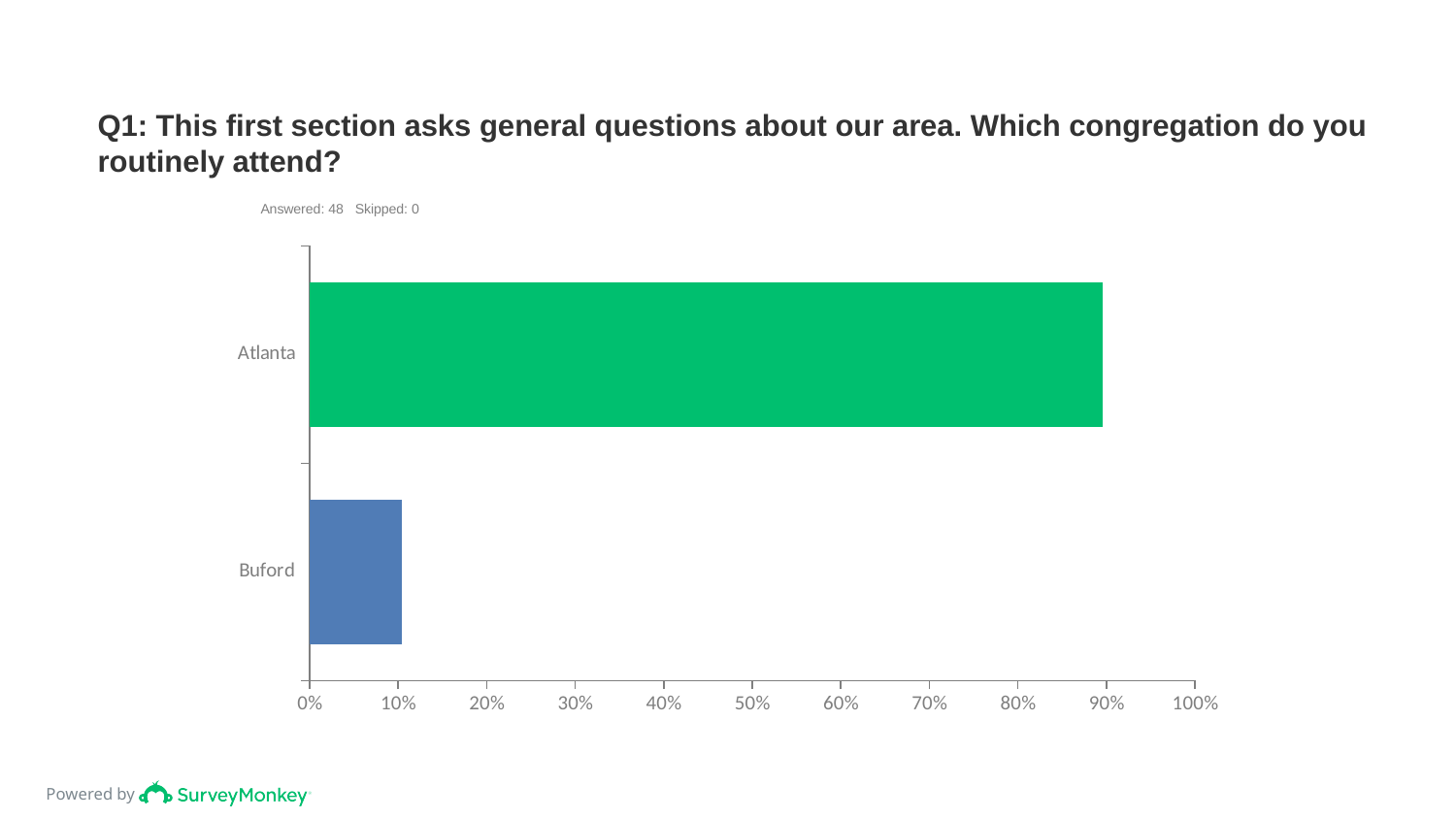
Is the value for Atlanta greater or less than 80%? greater Which congregation has the lowest value in the chart? Buford How many categories (congregations) are plotted in the chart? 2 Is the value for Buford greater or less than 20%? less What kind of chart is shown on the slide? bar chart How many respondents answered the question shown in the chart? 48 Is the value for Buford greater or less than 50%? less Which is larger, the value for Atlanta or the value for Buford? Atlanta What is the maximum value shown on the x axis of the chart? 100% Which congregation has the highest value in the chart? Atlanta